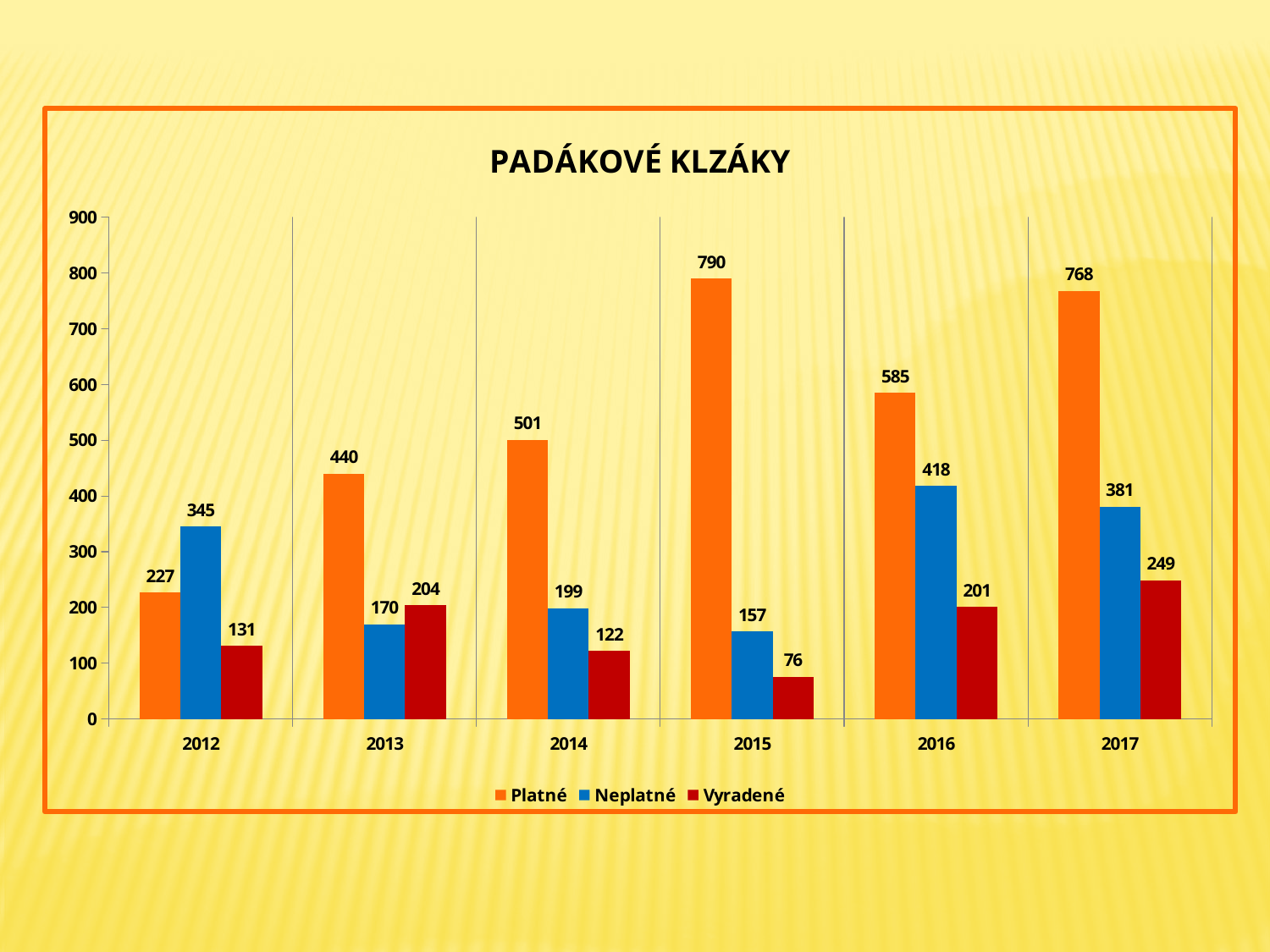
What is the Neplatné value for 2016? 418 What is the Platné value for 2015? 790 How many series does the legend list? 3 What is the title of the chart? PADÁKOVÉ KLZÁKY Which is larger in 2012, Platné or Neplatné? Neplatné Does the Platné value rise or fall from 2012 to 2015? rise Which year has the lowest Vyradené value? 2015 What kind of chart is shown? bar chart What is the Vyradené value for 2013? 204 Which year has the highest Platné value? 2015 What is the difference between the Platné values for 2017 and 2016? 183 How many years are shown on the x axis? 6